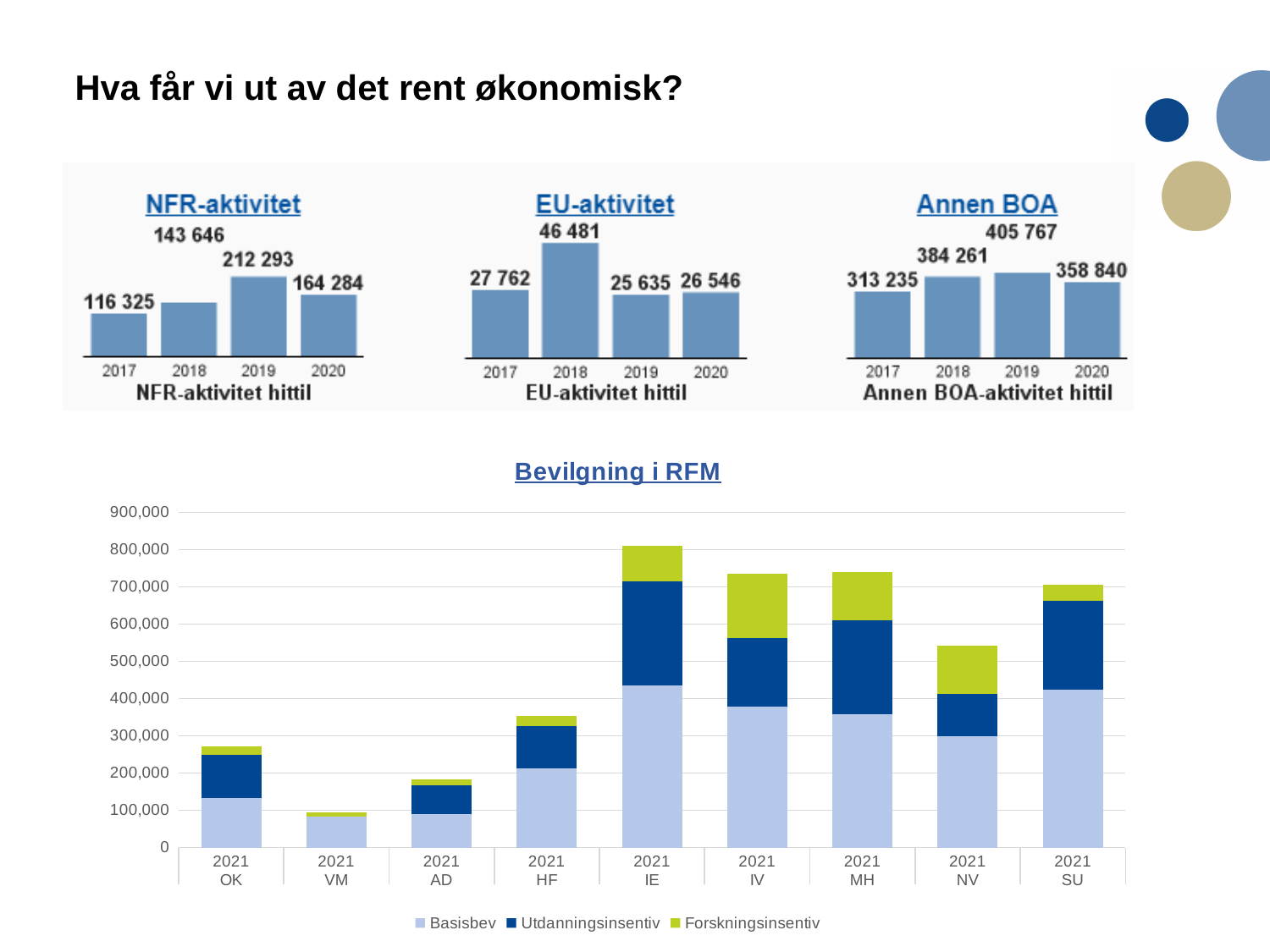
In the Bevilgning i RFM chart, is the total for 2021 NV greater or less than 500,000? greater In the Bevilgning i RFM chart, how many series does the legend list? 3 In the EU-aktivitet chart, what is the difference between the 2018 and 2019 values? 20 846 In the Bevilgning i RFM chart, how many categories are shown on the x axis? 9 In the EU-aktivitet chart, which year has the highest value? 2018 In the NFR-aktivitet chart, what is the difference between the 2019 and 2017 values? 95 968 In the Annen BOA chart, which year has the lowest value? 2017 What kind of chart is the Bevilgning i RFM chart? stacked bar chart In the EU-aktivitet chart, what is the value for 2017? 27 762 In the Annen BOA chart, which is larger, the value for 2018 or the value for 2020? 2018 In the NFR-aktivitet chart, what is the value for 2019? 212 293 In the Bevilgning i RFM chart, which category has the highest total bar? 2021 IE